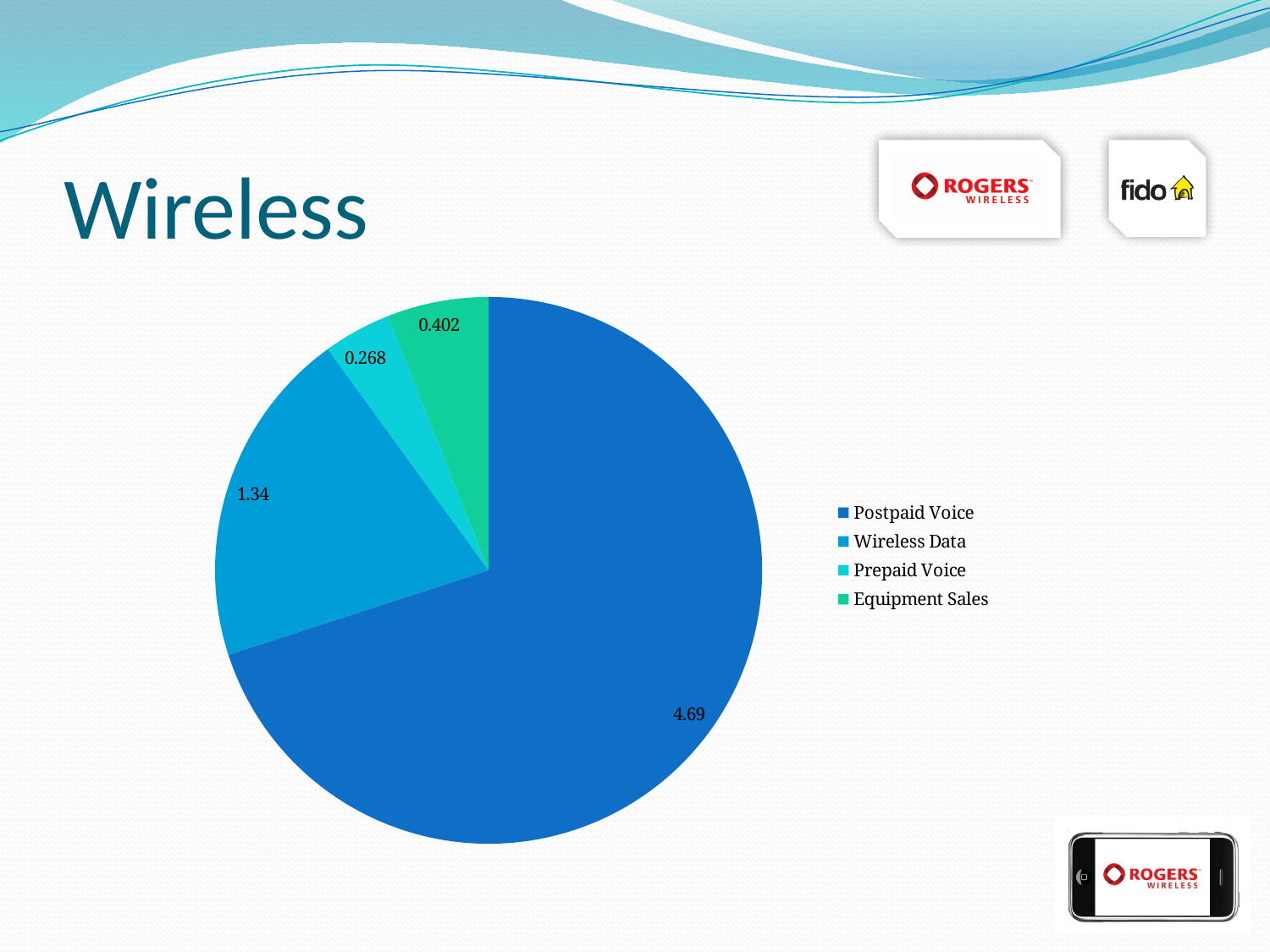
What is the value for Prepaid Voice? 0.268 What type of chart is shown on the slide? Pie chart Which is larger, Equipment Sales or Prepaid Voice? Equipment Sales What is the difference between the values for Postpaid Voice and Wireless Data? 3.35 Which category has the smallest slice of the pie? Prepaid Voice How many categories does the legend list? 4 What is the total of all the slices in the pie? 6.7 What share of the pie does Postpaid Voice represent? 70% What is the value for Postpaid Voice? 4.69 What is the value for Equipment Sales? 0.402 What is the value for Wireless Data? 1.34 Which category has the largest slice of the pie? Postpaid Voice